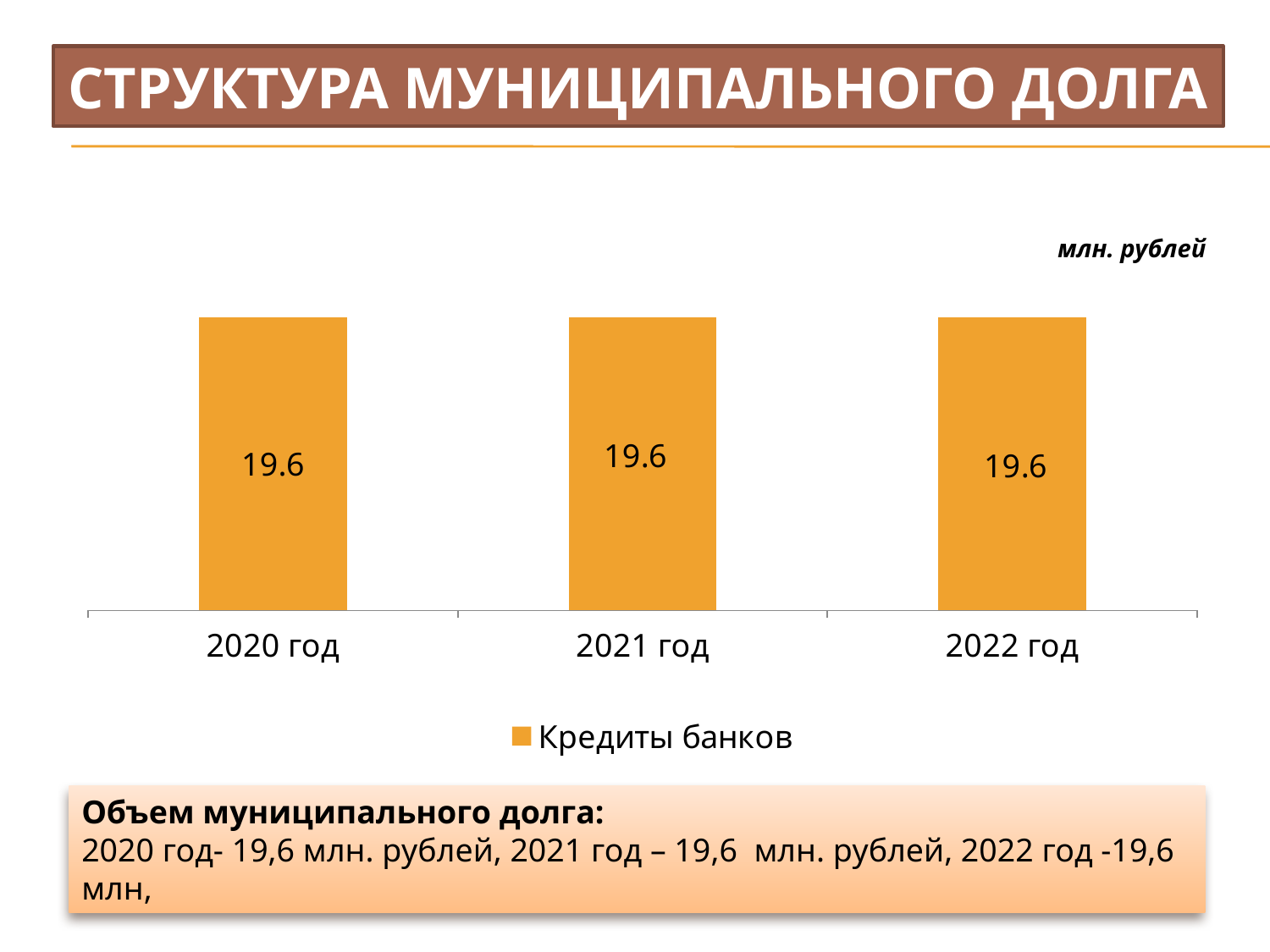
How many series does the legend list? 1 What is the difference between the values for 2020 год and 2022 год? 0 What unit is indicated above the chart? млн. рублей How many categories are shown on the x axis? 3 Do the values rise, fall or stay the same from 2020 год to 2022 год? stay the same What is the value for 2021 год? 19.6 What is the name of the series listed in the legend? Кредиты банков What kind of chart is shown on the slide? bar chart What is the value for 2020 год? 19.6 What is the value for 2022 год? 19.6